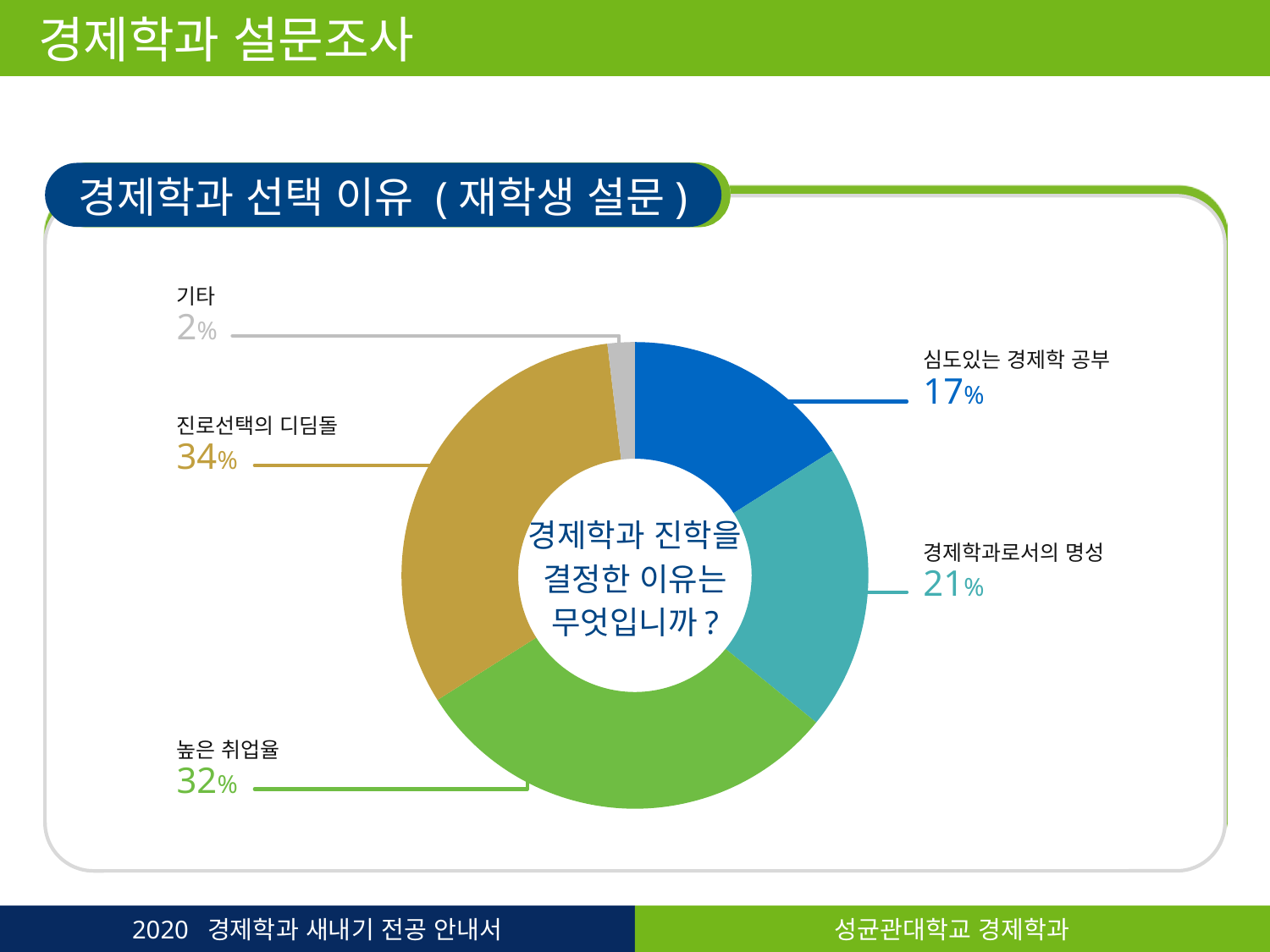
How many categories are shown in the chart? 5 What percentage is shown for 심도있는 경제학 공부? 17% What percentage is shown for 높은 취업율? 32% What is the difference in percentage points between 진로선택의 디딤돌 and 높은 취업율? 2 Which category has the smallest share in the chart? 기타 Which category has the largest share in the chart? 진로선택의 디딤돌 What percentage is shown for 기타? 2% What percentage is shown for 경제학과로서의 명성? 21% Which is larger, the share for 경제학과로서의 명성 or the share for 심도있는 경제학 공부? 경제학과로서의 명성 What percentage of respondents chose 진로선택의 디딤돌 as their reason? 34% What kind of chart is shown on the slide? Doughnut (pie) chart What question is written in the centre of the chart? 경제학과 진학을 결정한 이유는 무엇입니까?